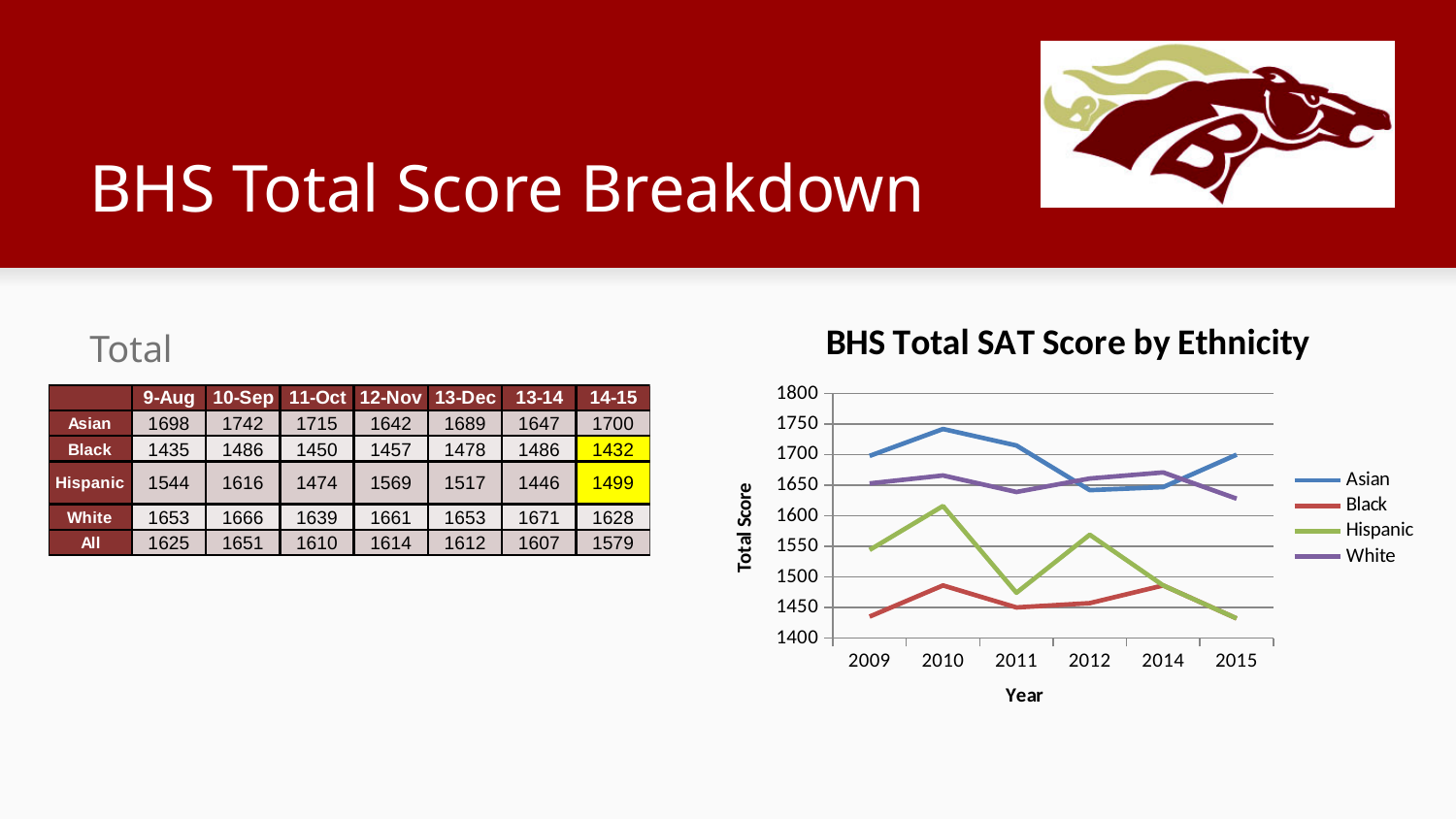
What type of chart is 'BHS Total SAT Score by Ethnicity'? line chart In 'BHS Total SAT Score by Ethnicity', is the Hispanic value for 2011 greater or less than 1500? less In 'BHS Total SAT Score by Ethnicity', which series has the higher value in 2009, Asian or White? Asian In 'BHS Total SAT Score by Ethnicity', in which year is the Hispanic series highest? 2010 How many series does the legend of 'BHS Total SAT Score by Ethnicity' list? 4 In 'BHS Total SAT Score by Ethnicity', is the White value for 2015 greater or less than 1600? greater In 'BHS Total SAT Score by Ethnicity', which series has the higher value in 2010, Hispanic or Black? Hispanic In 'BHS Total SAT Score by Ethnicity', what is the label of the y axis? Total Score In 'BHS Total SAT Score by Ethnicity', in which year is the Asian series highest? 2010 How many years are shown on the x axis of 'BHS Total SAT Score by Ethnicity'? 6 In 'BHS Total SAT Score by Ethnicity', is the Asian value for 2010 greater or less than 1700? greater